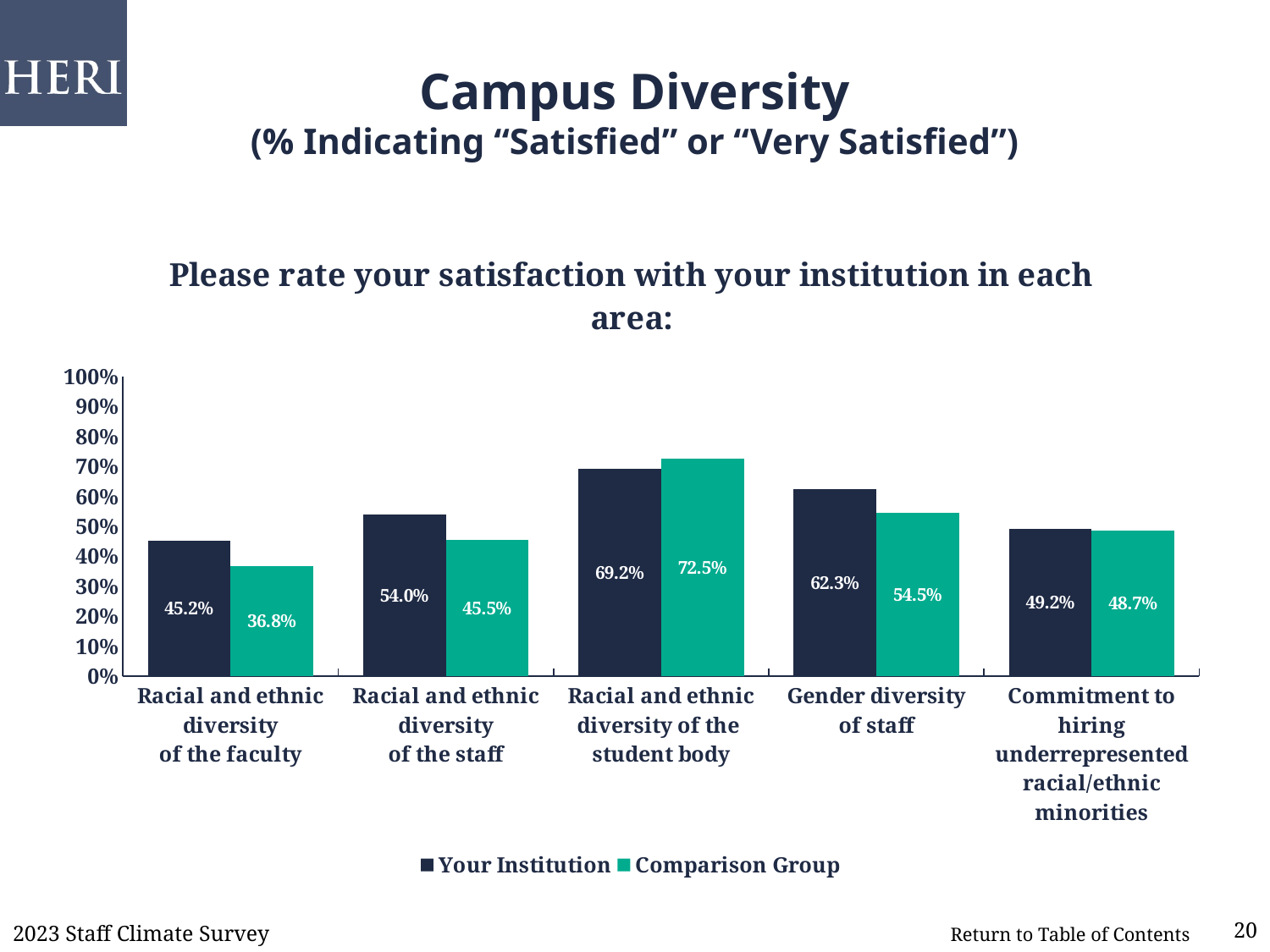
What is the value for Comparison Group for Gender diversity of staff? 54.5% What is the title of the chart? Please rate your satisfaction with your institution in each area: What is the value for Comparison Group for Racial and ethnic diversity of the student body? 72.5% Which category has the highest value for Your Institution? Racial and ethnic diversity of the student body How many categories are shown on the x axis? 5 How many series does the legend list? 2 Is the value for Your Institution for Racial and ethnic diversity of the student body greater or less than 60%? greater What is the value for Your Institution for Racial and ethnic diversity of the faculty? 45.2% What kind of chart is shown on the slide? Bar chart Which category has the lowest value for Comparison Group? Racial and ethnic diversity of the faculty Which is larger for Gender diversity of staff: Your Institution or Comparison Group? Your Institution What is the difference between Your Institution and Comparison Group for Racial and ethnic diversity of the staff? 8.5%